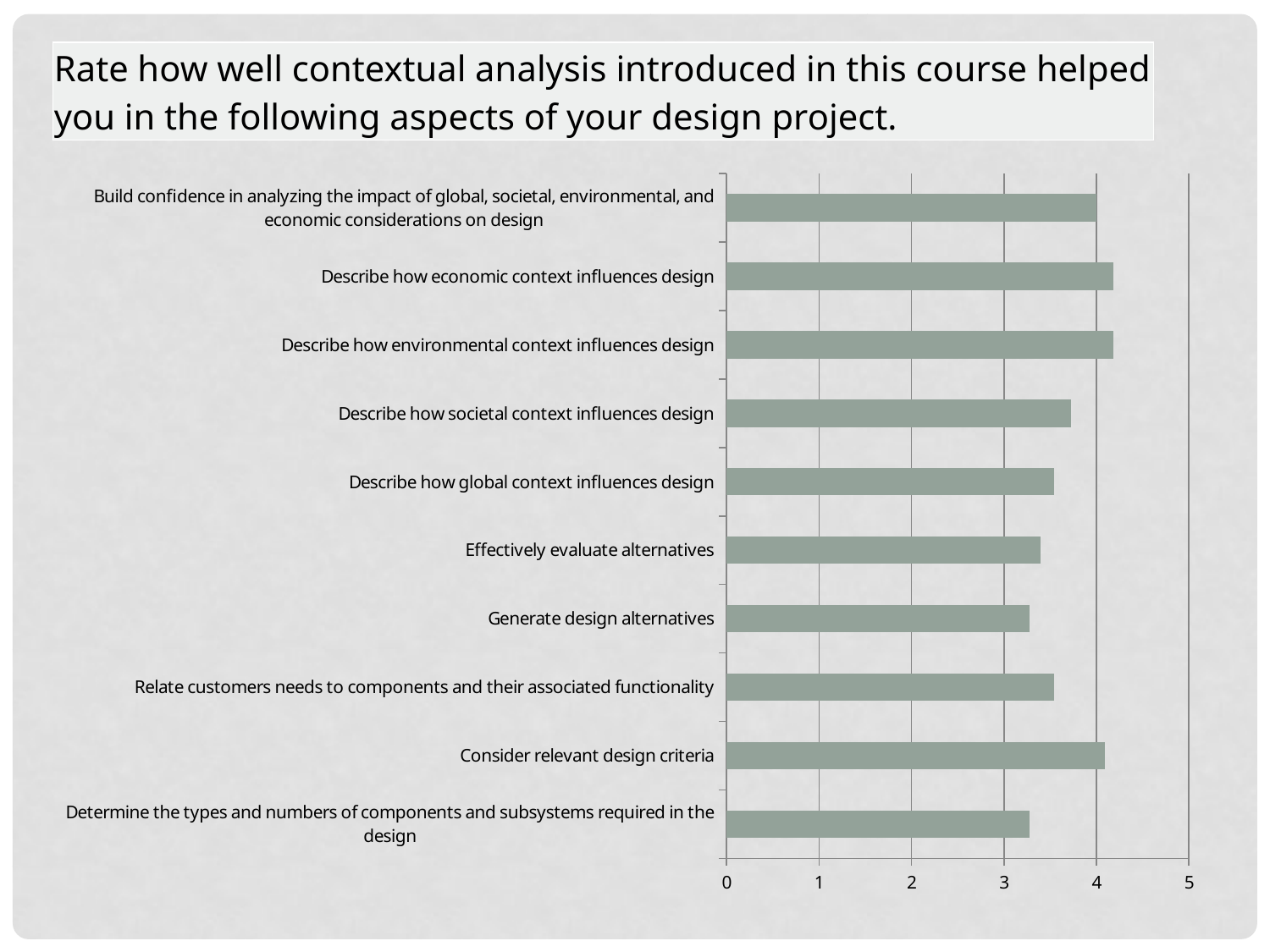
Is the value for "Generate design alternatives" greater or less than 4? less Which has the larger value: "Describe how societal context influences design" or "Generate design alternatives"? Describe how societal context influences design What kind of chart is shown on the slide? bar chart What is the title of the slide above the chart? Rate how well contextual analysis introduced in this course helped you in the following aspects of your design project. Is the value for "Describe how environmental context influences design" greater or less than 4? greater How many categories (aspects) are plotted in the chart? 10 Is the value for "Describe how economic context influences design" greater or less than 4? greater What is the highest value shown on the horizontal axis of the chart? 5 Which has the larger value: "Consider relevant design criteria" or "Effectively evaluate alternatives"? Consider relevant design criteria